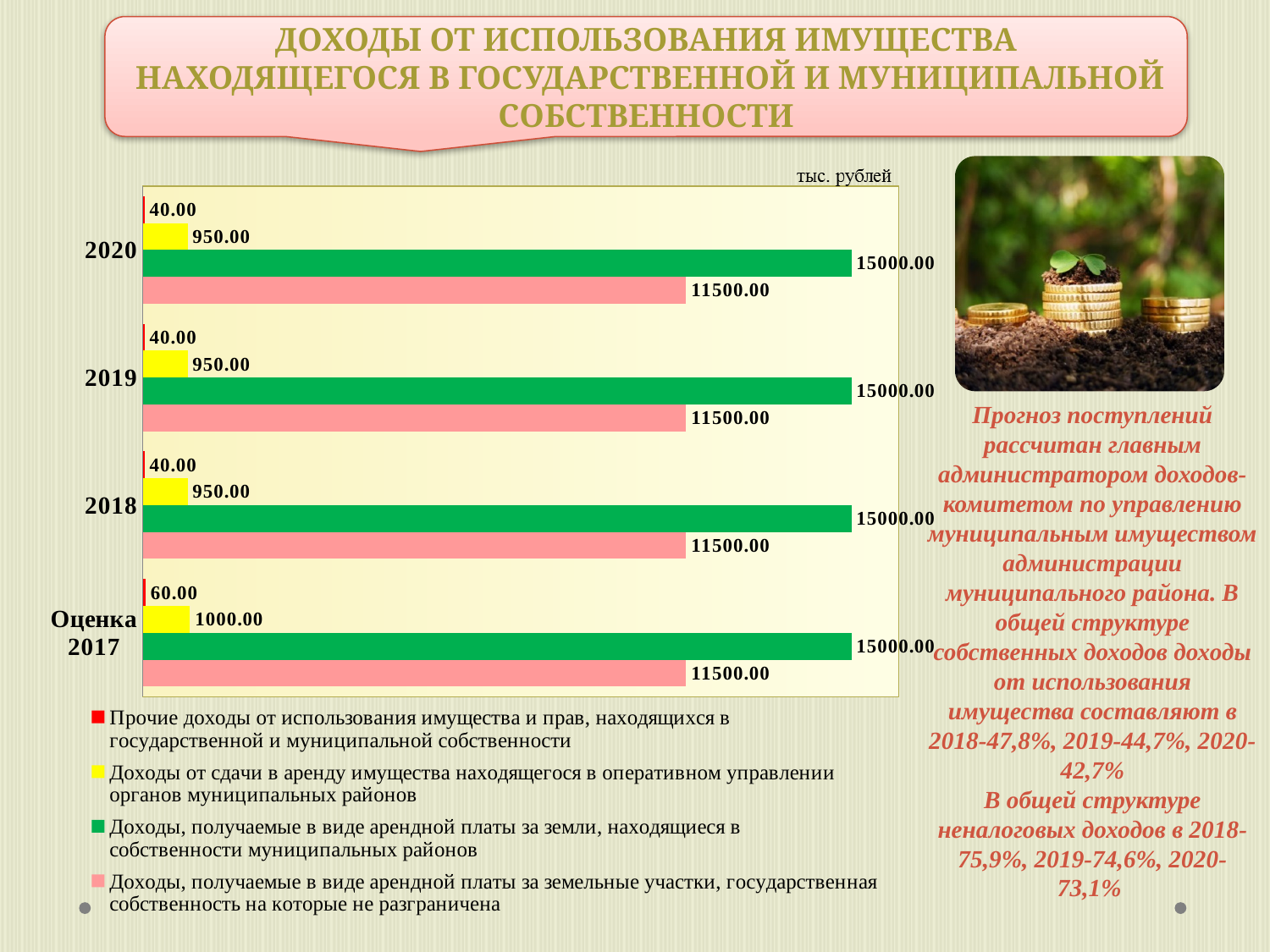
Какой ряд имеет наибольшее значение в 2020 году? Доходы, получаемые в виде арендной платы за земли, находящиеся в собственности муниципальных районов Сколько рядов данных перечислено в легенде диаграммы? 4 Какой ряд имеет наименьшее значение в 2018 году? Прочие доходы от использования имущества и прав, находящихся в государственной и муниципальной собственности Каково значение ряда «Доходы, получаемые в виде арендной платы за земли, находящиеся в собственности муниципальных районов» за 2020 год? 15000.00 Как меняется значение ряда «Прочие доходы от использования имущества и прав» от Оценки 2017 к 2018 году — растёт или падает? Падает Каково значение ряда «Доходы, получаемые в виде арендной платы за земельные участки, государственная собственность на которые не разграничена» за 2018 год? 11500.00 В каких единицах измерения приведены значения на диаграмме? тыс. рублей Какой тип диаграммы показан на слайде? Столбчатая (bar chart) На сколько значение ряда «Доходы, получаемые в виде арендной платы за земли, находящиеся в собственности муниципальных районов» больше значения ряда «Доходы, получаемые в виде арендной платы за земельные участки, государственная собственность на которые не разграничена» в 2019 году? 3500.00 Каково значение ряда «Доходы от сдачи в аренду имущества находящегося в оперативном управлении органов муниципальных районов» за 2019 год? 950.00 Сколько категорий (периодов) показано на диаграмме? 4 Каково значение ряда «Прочие доходы от использования имущества и прав, находящихся в государственной и муниципальной собственности» за Оценку 2017? 60.00